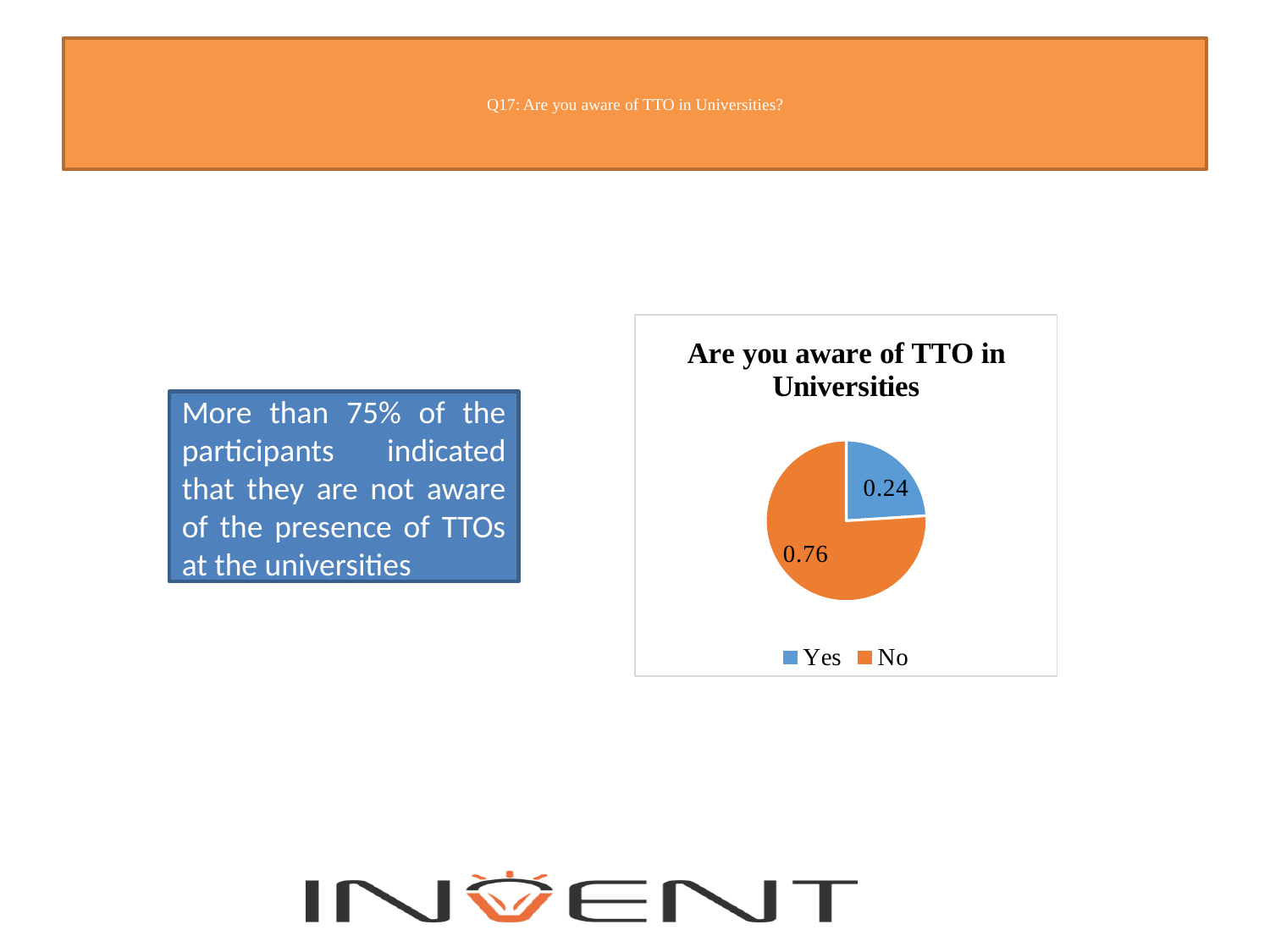
What colour is the No slice in the pie chart? orange Which slice of the pie chart is the largest? No What is the value for Yes in the pie chart? 0.24 What is the value for No in the pie chart? 0.76 What is the title of the pie chart? Are you aware of TTO in Universities How many slices does the pie chart have? 2 What is the difference between the No and Yes values in the pie chart? 0.52 How many entries does the legend of the pie chart list? 2 Which slice of the pie chart is the smallest? Yes Which is larger in the pie chart, Yes or No? No What kind of chart is shown on the slide? pie chart